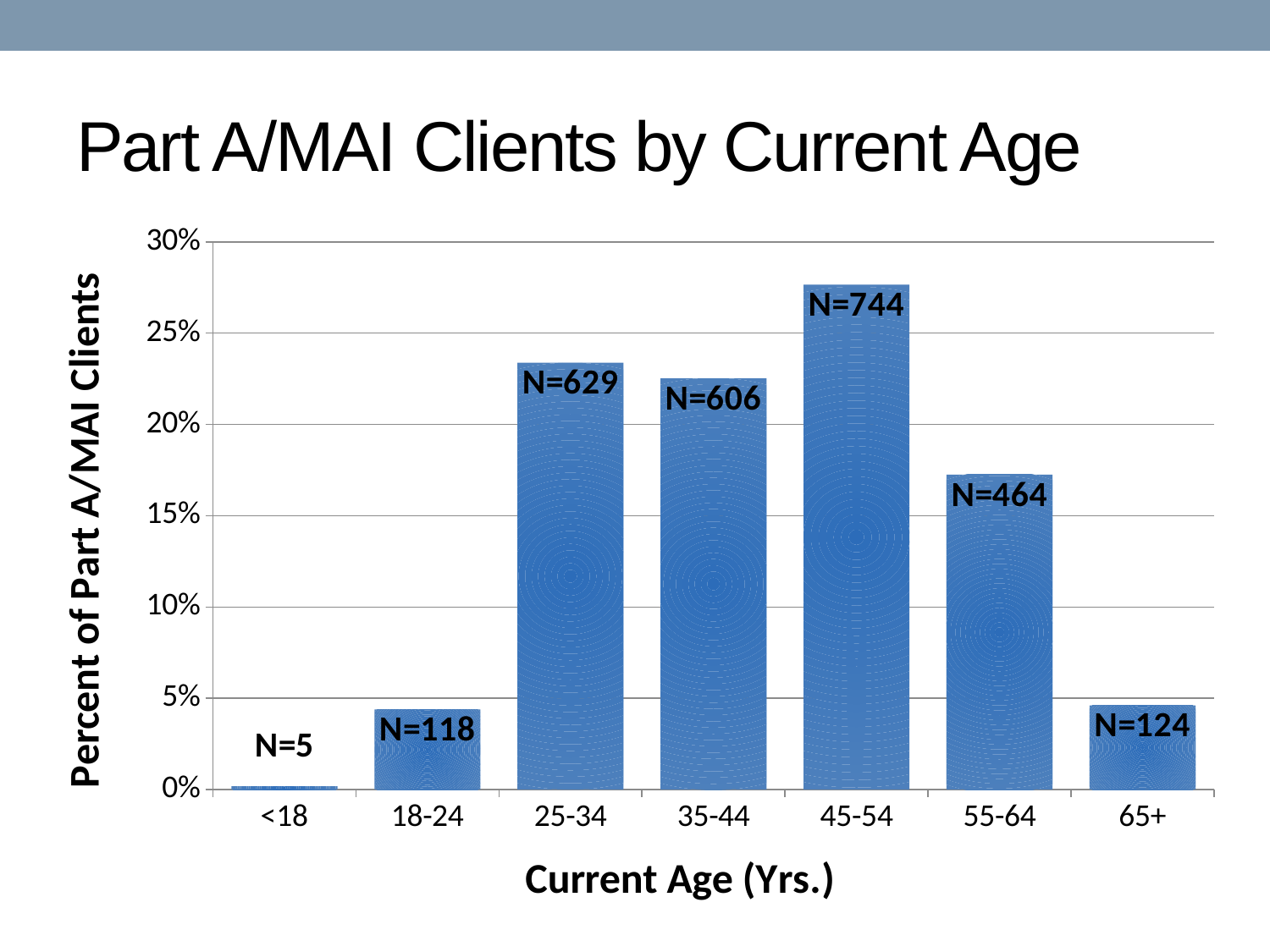
Is the value for the 55-64 age group greater or less than 20%? less What is the N value shown for the 45-54 age group? N=744 Which age group has the lowest percent of Part A/MAI clients? <18 Which age group has the highest percent of Part A/MAI clients? 45-54 Is the value for the 25-34 age group greater or less than 20%? greater What is the N value shown for the 55-64 age group? N=464 How many age groups are shown on the x axis? 7 Which has a higher percent of clients, the 45-54 age group or the 55-64 age group? 45-54 Is the value for the 65+ age group greater or less than 10%? less How many more clients (N) are in the 45-54 age group than in the 25-34 age group? 115 What is the N value shown for the <18 age group? N=5 What kind of chart is shown on the slide? Bar chart